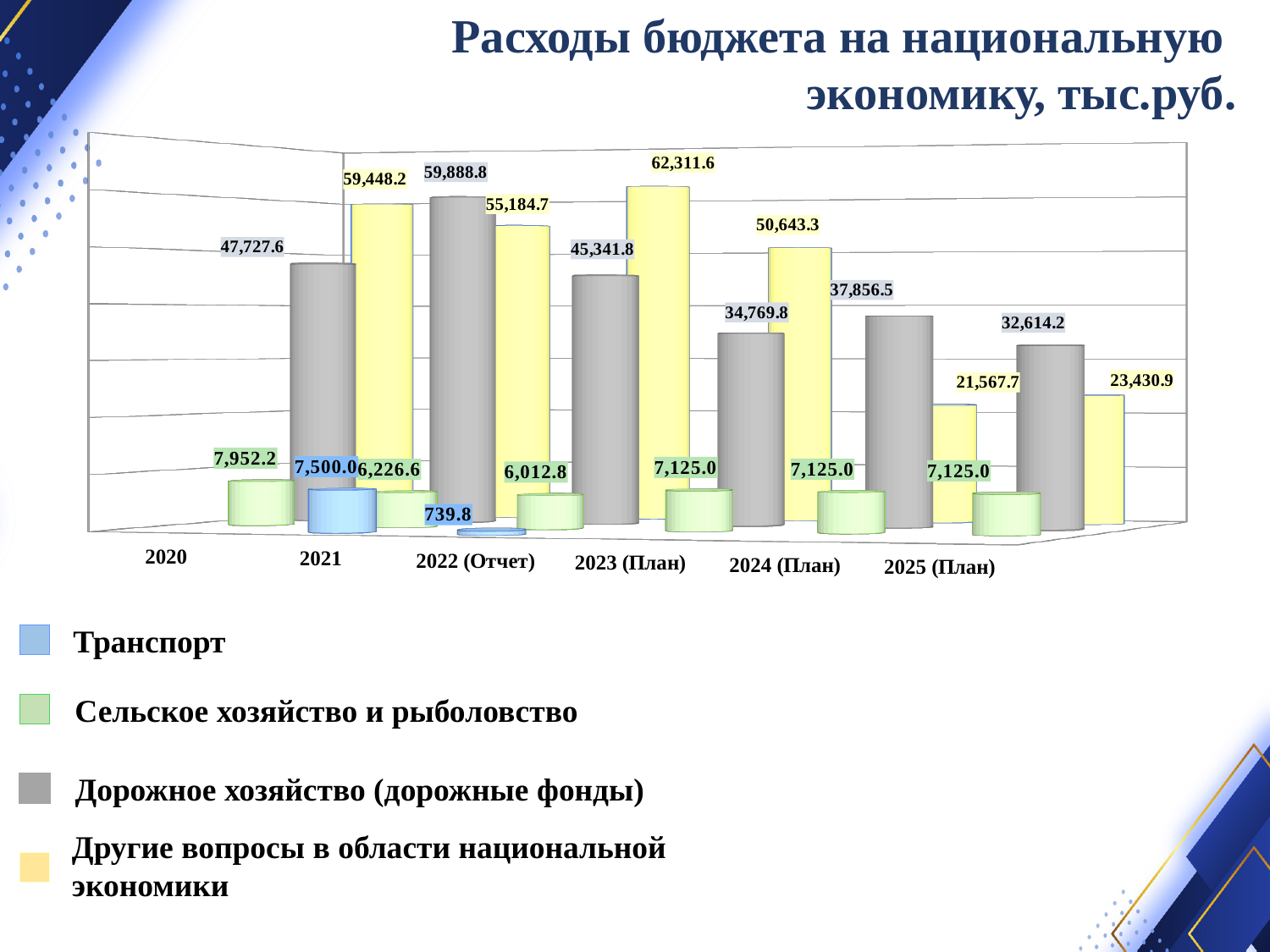
In which year is the value for Другие вопросы в области национальной экономики the highest? 2022 (Отчет) What kind of chart is shown on the slide? bar chart What is the value for Сельское хозяйство и рыболовство in 2024 (План)? 7,125.0 What is the value for Транспорт in 2021? 7,500.0 How many series does the legend list? 4 What is the value for Дорожное хозяйство (дорожные фонды) in 2020? 47,727.6 How many year categories are shown on the x axis? 6 What is the difference between the Дорожное хозяйство (дорожные фонды) values for 2021 and 2020? 12,161.2 In which year is the value for Дорожное хозяйство (дорожные фонды) the lowest? 2025 (План) What is the value for Другие вопросы в области национальной экономики in 2022 (Отчет)? 62,311.6 In 2023 (План), which is larger: Дорожное хозяйство (дорожные фонды) or Другие вопросы в области национальной экономики? Другие вопросы в области национальной экономики What is the title of the chart? Расходы бюджета на национальную экономику, тыс.руб.